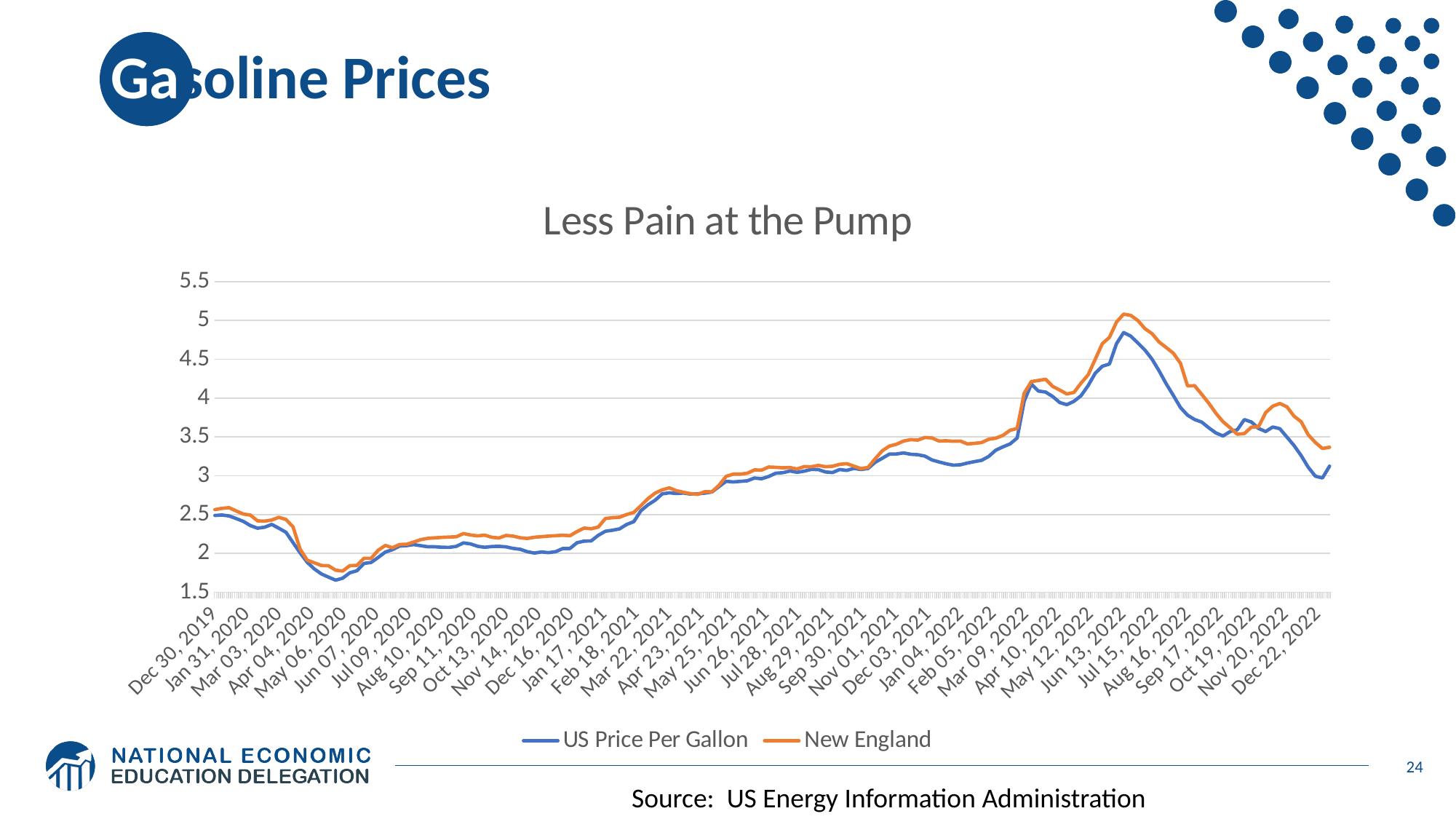
What kind of chart is shown on the slide? line chart Which colour is used for the New England series? orange Is the highest value reached by the US Price Per Gallon series greater or less than 4.5? greater Do gasoline prices rise or fall between Dec 30, 2019 and May 06, 2020? fall Is the highest value reached by the New England series greater or less than 5? greater How many series does the chart's legend list? 2 Is the lowest value of the US Price Per Gallon series greater or less than 2? less At Dec 22, 2022, which series is higher, US Price Per Gallon or New England? New England Do gasoline prices rise or fall between Jun 13, 2022 and Dec 22, 2022? fall At the mid-2022 peak, which series is higher, US Price Per Gallon or New England? New England What is the title of the chart? Less Pain at the Pump